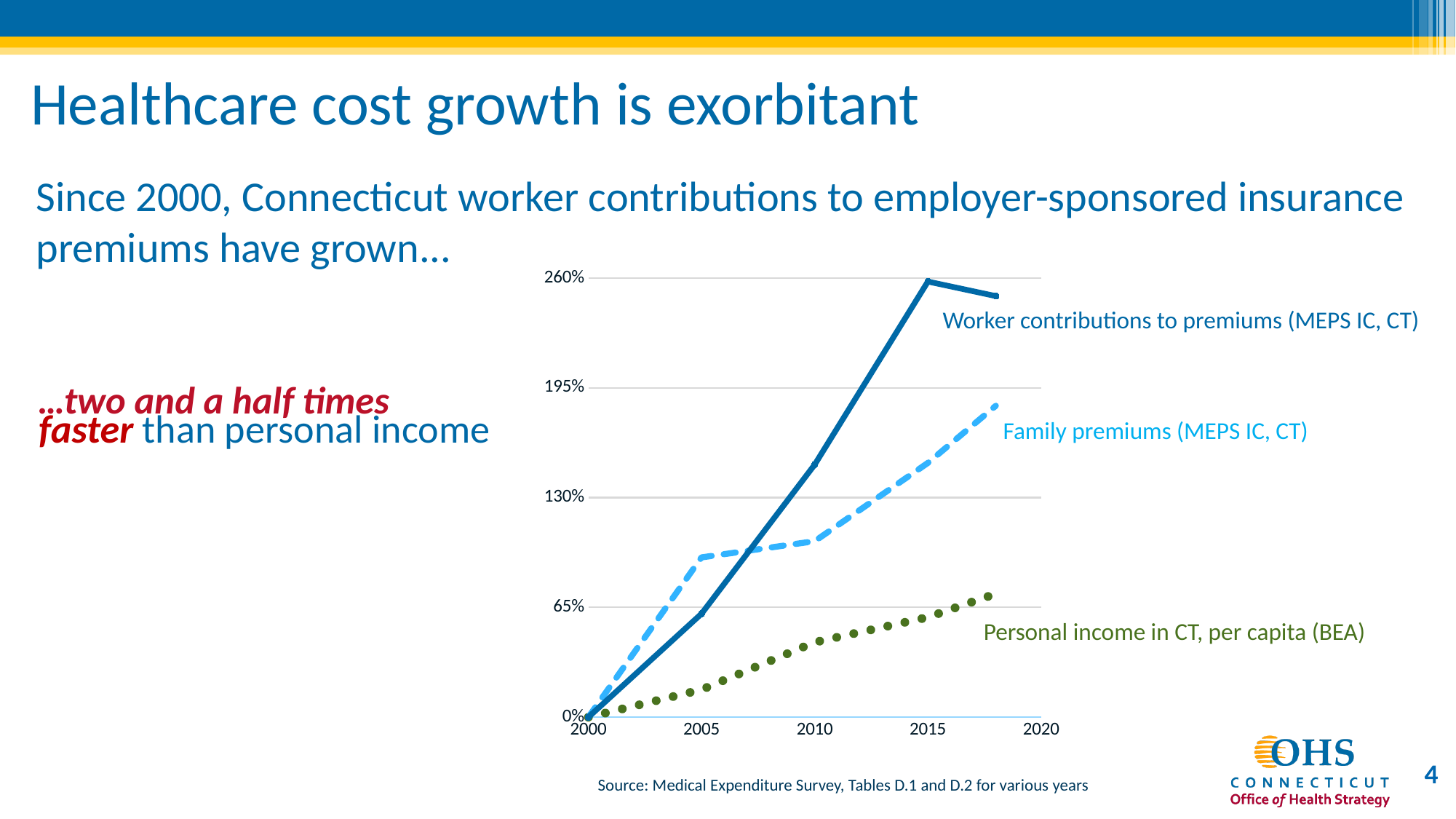
Is the value for Family premiums in 2005 greater or less than 65%? greater How many data series are plotted on the chart? 3 Is the value for Worker contributions to premiums in 2010 greater or less than 130%? greater In 2005, which is larger: Family premiums or Worker contributions to premiums? Family premiums Is the value for Worker contributions to premiums in 2015 greater or less than 195%? greater What kind of chart is shown on the slide? line chart Which series has the lowest value at the end of the period (2018)? Personal income in CT, per capita (BEA) Which series has the highest value at the end of the period (2018)? Worker contributions to premiums (MEPS IC, CT) Does the Personal income in CT, per capita series rise or fall from 2000 to 2018? rise In 2010, which is larger: Worker contributions to premiums or Family premiums? Worker contributions to premiums What is the highest value shown on the chart's vertical axis? 260%